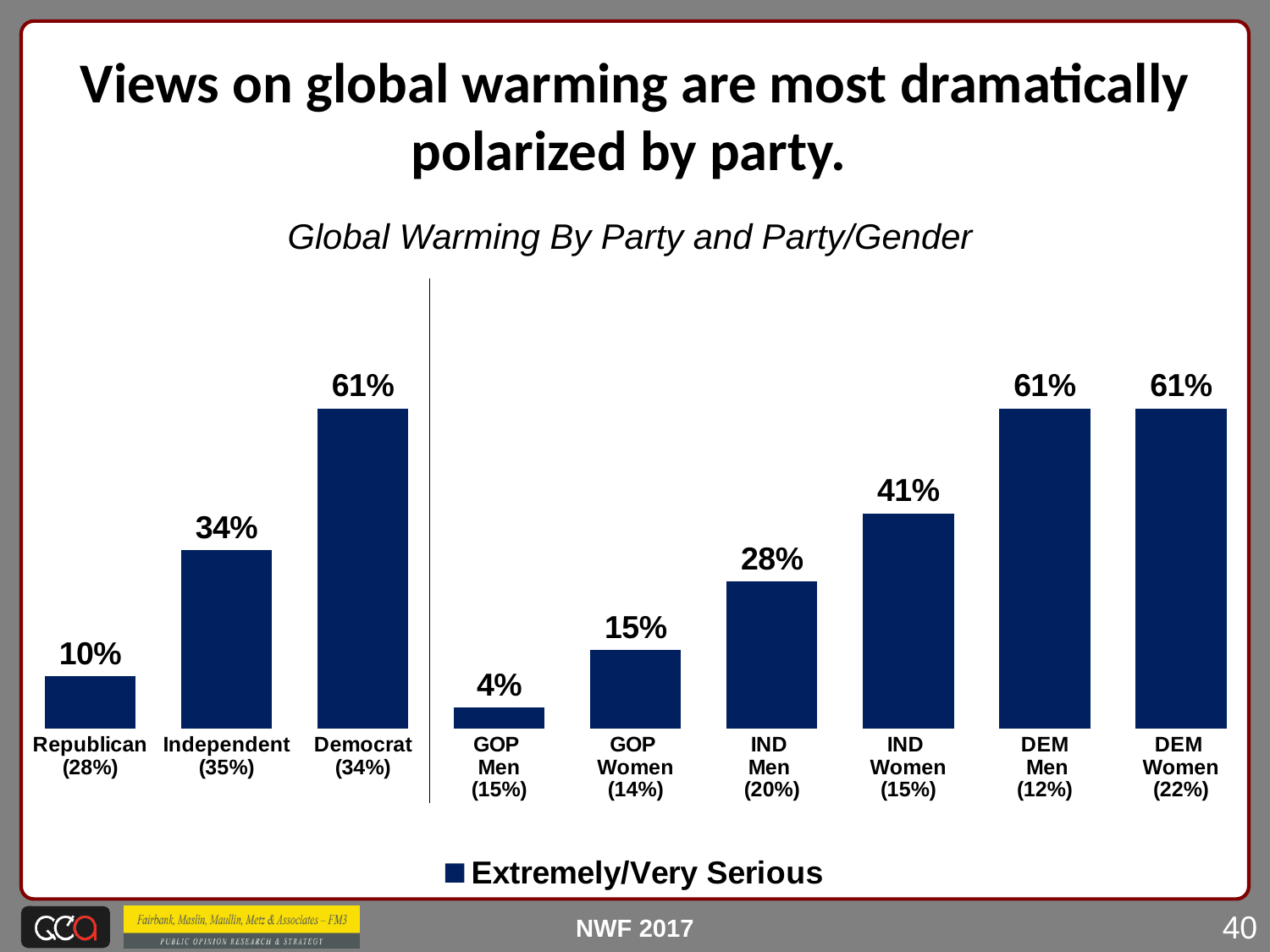
What is the value for IND Women? 41% What is the value for GOP Men? 4% What is the title of the chart? Global Warming By Party and Party/Gender Which is larger, the value for GOP Women or the value for IND Men? IND Men Among Republican, Independent and Democrat, which has the highest value? Democrat How many series does the legend list? 1 Which category has the lowest value on the chart? GOP Men How many categories are shown on the chart? 9 What is the difference between the values for Democrat and Republican? 51% What kind of chart is shown on the slide? Bar chart What percentage of Republicans rate global warming as Extremely/Very Serious? 10% What is the difference between the values for IND Women and IND Men? 13%